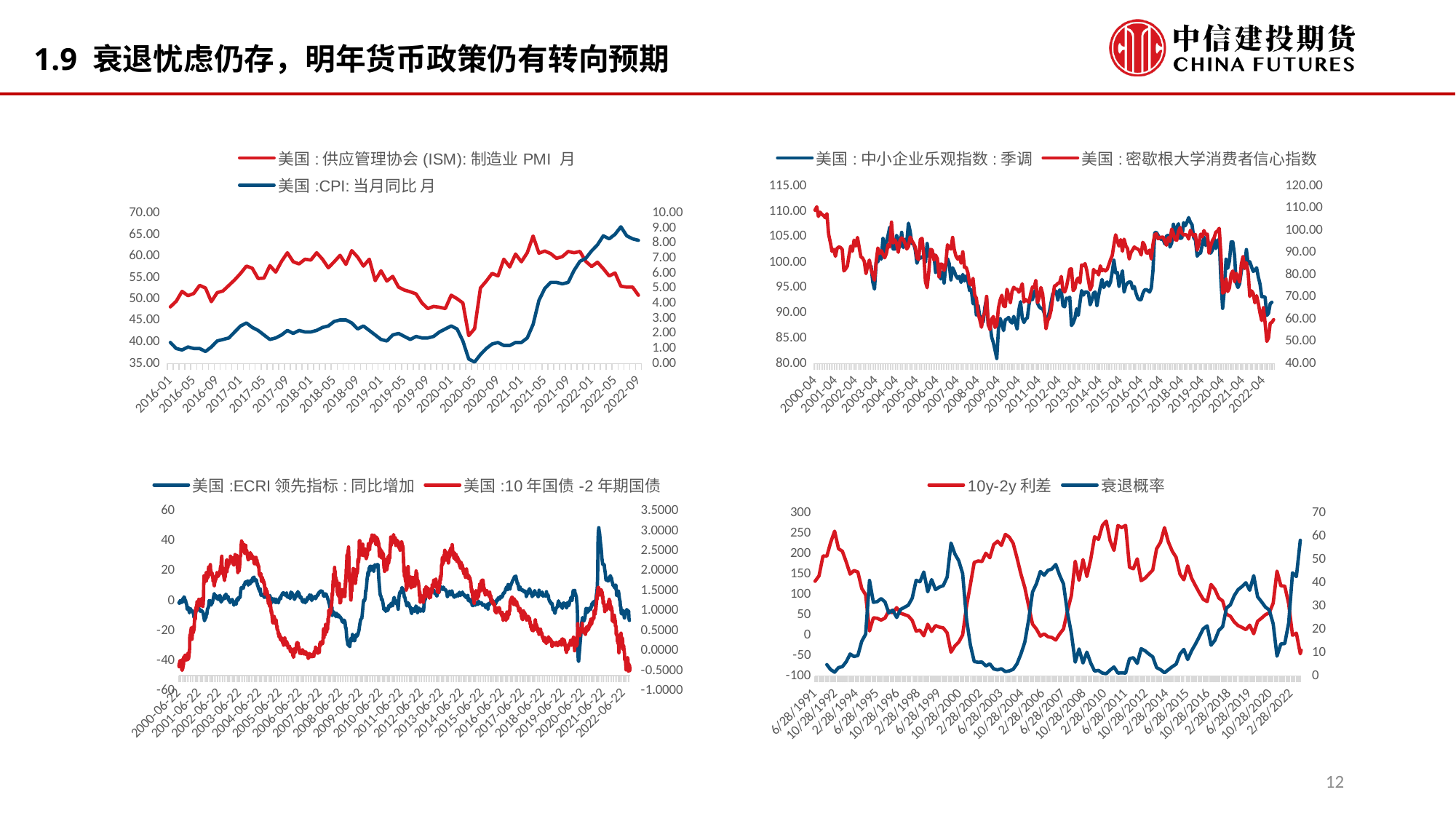
In the bottom-right chart, which series is drawn in red according to the legend? 10y-2y 利差 In the top-right chart, is the value of 美国:密歇根大学消费者信心指数 at 2022-04 greater or less than 80.00 on the right axis? less In the top-left chart, is the value of 美国:CPI:当月同比 at 2022-09 greater or less than 5.00 on the right axis? greater In the top-left chart, does the 美国:CPI:当月同比 line rise or fall between 2020-05 and 2022-05? rise In the top-left chart, is the value of 美国:供应管理协会(ISM):制造业PMI at 2022-09 greater or less than 55.00 on the left axis? less How many series does the legend of the top-left chart (ISM manufacturing PMI and CPI) list? 2 In the top-right chart, does the 美国:密歇根大学消费者信心指数 line rise or fall between 2020-04 and 2022-04? fall In the bottom-left chart, which series is drawn in blue according to the legend? 美国:ECRI 领先指标:同比增加 What kind of chart is the top-left chart showing the ISM manufacturing PMI and CPI? Line chart